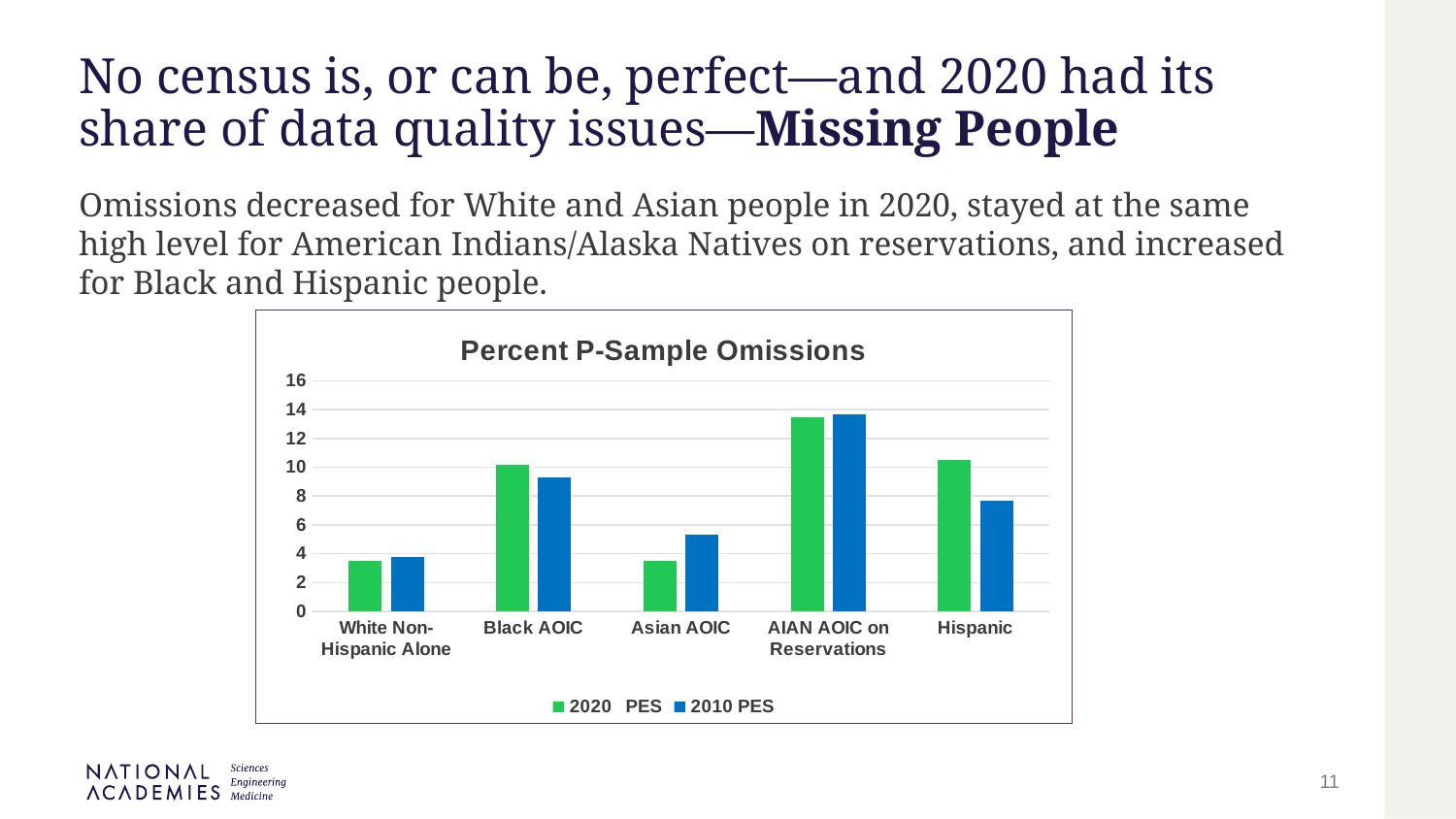
Is the 2010 PES value for Asian AOIC greater or less than 4? greater For Hispanic, which is larger: the 2020 PES value or the 2010 PES value? 2020 PES What type of chart is shown on the slide? bar chart Is the 2020 PES value for Black AOIC greater or less than 8? greater Which category has the highest 2020 PES value? AIAN AOIC on Reservations How many series does the legend list? 2 How many categories are shown on the x axis? 5 For Asian AOIC, which is larger: the 2020 PES value or the 2010 PES value? 2010 PES Is the 2020 PES value for AIAN AOIC on Reservations greater or less than 12? greater Which category has the lowest 2010 PES value? White Non-Hispanic Alone What is the title of the chart? Percent P-Sample Omissions